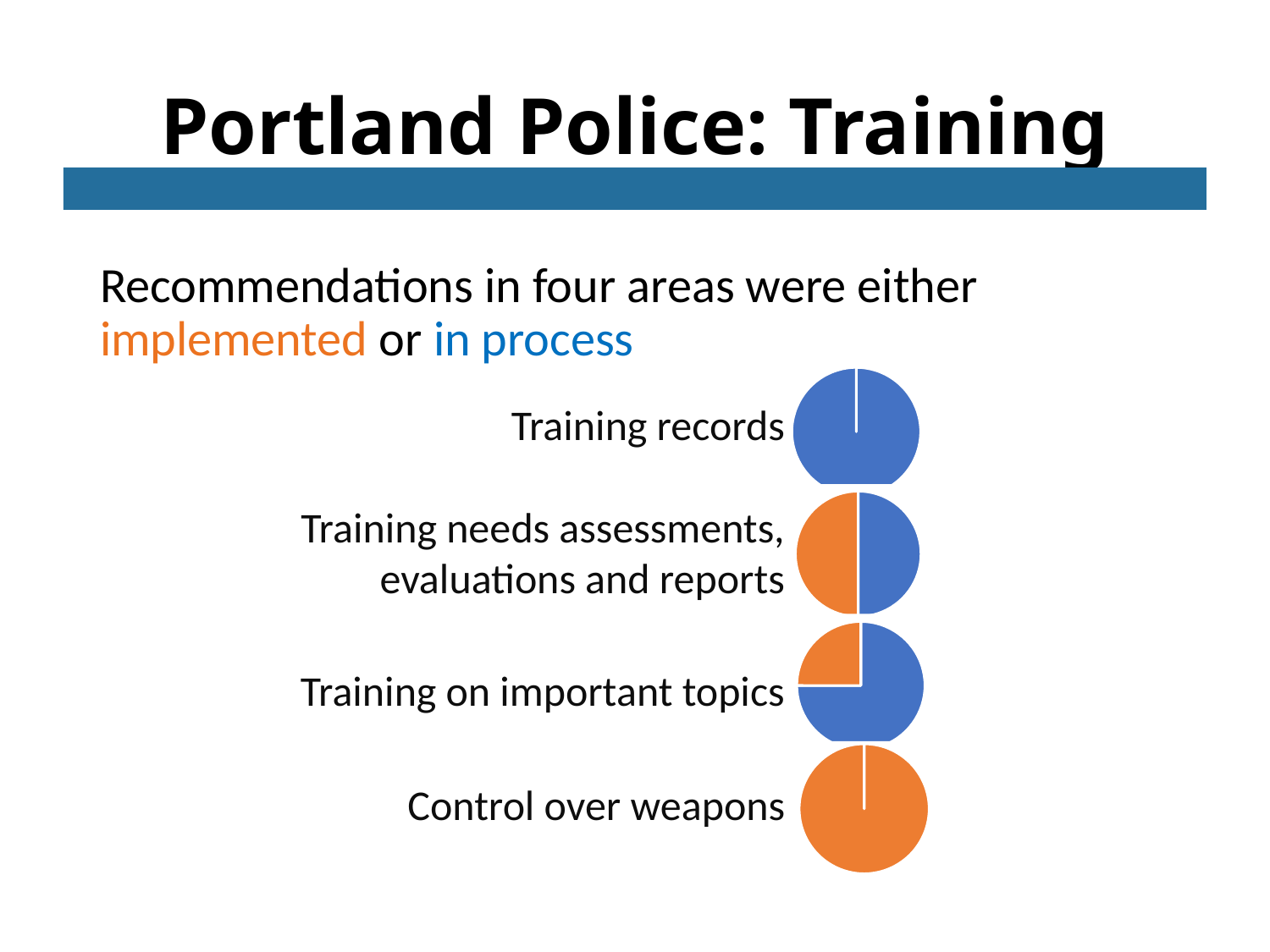
Which area's pie chart shows the lowest share of implemented recommendations? Training records In the "Training on important topics" pie chart, which slice is larger, implemented or in process? in process How many training areas are shown with a pie chart on the slide? 4 Which colour in the pie charts represents recommendations that are in process? blue What kind of chart is used for "Training records"? pie chart Which area has a larger in process share, "Training records" or "Training on important topics"? Training records Which area's pie chart shows the lowest share of recommendations in process? Control over weapons Which area's pie chart shows the highest share of recommendations in process? Training records How many pie charts are shown on the slide? 4 Which area's pie chart shows the highest share of implemented recommendations? Control over weapons Which area has a larger implemented share, "Training on important topics" or "Training needs assessments, evaluations and reports"? Training needs assessments, evaluations and reports Which colour in the pie charts represents recommendations that were implemented? orange